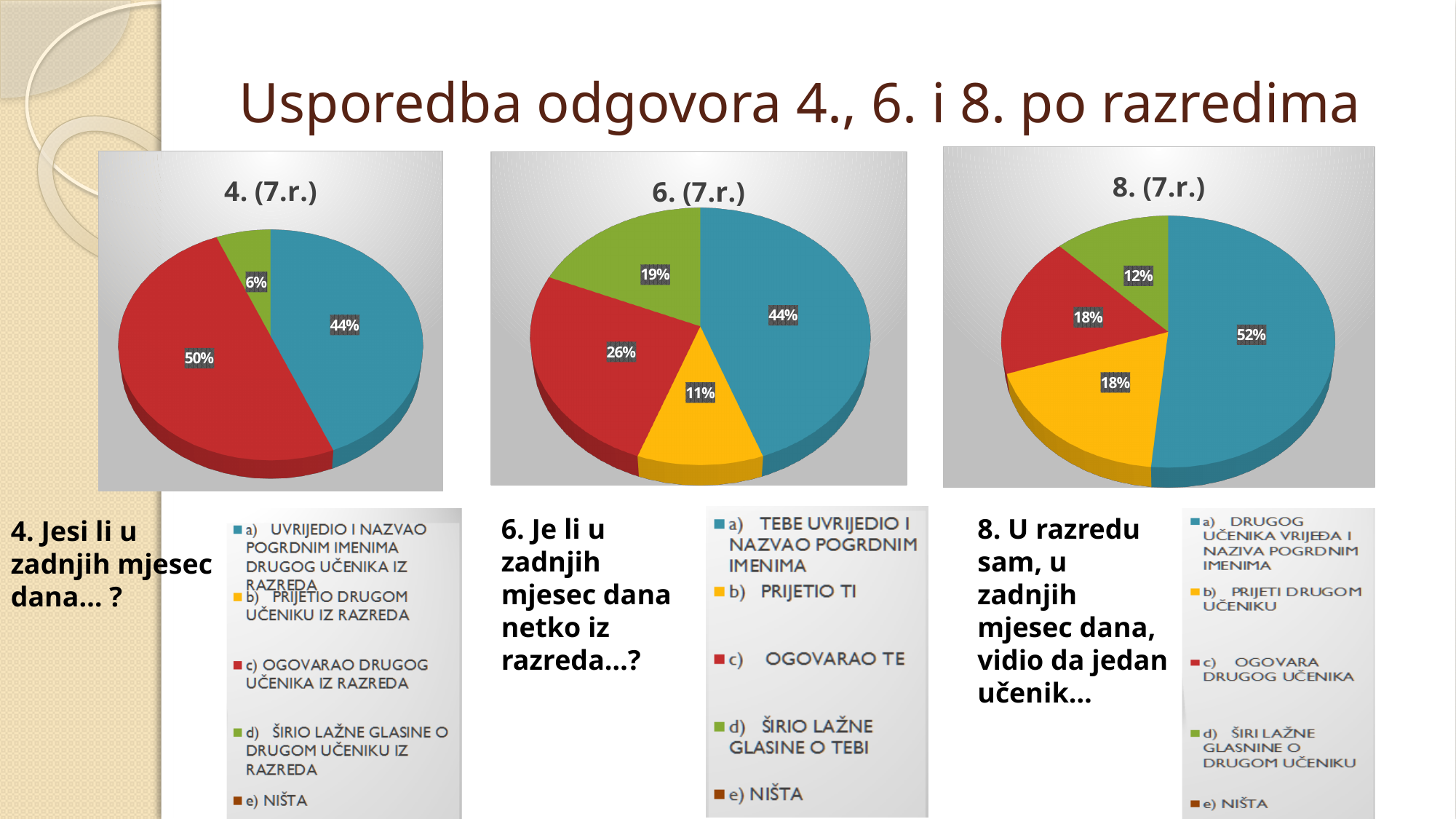
In the pie chart titled "8. (7.r.)", what percentage is shown for the green slice (d) ŠIRI LAŽNE GLASNINE)? 12% In the pie chart titled "6. (7.r.)", which slice is the smallest? b) PRIJETIO TI (11%) In the pie chart titled "6. (7.r.)", what percentage is shown for the red slice (c) OGOVARAO TE)? 26% In the pie chart titled "6. (7.r.)", what is the difference between the blue slice (44%) and the green slice (19%)? 25% In the pie chart titled "8. (7.r.)", how many slices with percentage labels are shown? 4 In the pie chart titled "4. (7.r.)", what percentage is shown for the red slice (c) OGOVARAO DRUGOG UČENIKA IZ RAZREDA)? 50% In the pie chart titled "4. (7.r.)", what percentage is shown for the green slice (d) ŠIRIO LAŽNE GLASINE)? 6% In the pie chart titled "6. (7.r.)", what percentage is shown for the yellow slice (b) PRIJETIO TI)? 11% What type of chart is used for the three charts on the slide? Pie chart In the pie chart titled "4. (7.r.)", which slice is the largest? c) OGOVARAO DRUGOG UČENIKA IZ RAZREDA (50%) Which is larger: the blue slice in the "6. (7.r.)" chart or the blue slice in the "8. (7.r.)" chart? 8. (7.r.) (52%) In the pie chart titled "8. (7.r.)", what percentage is shown for the blue slice (a) DRUGOG UČENIKA VRIJEĐA I NAZIVA POGRDNIM IMENIMA)? 52%